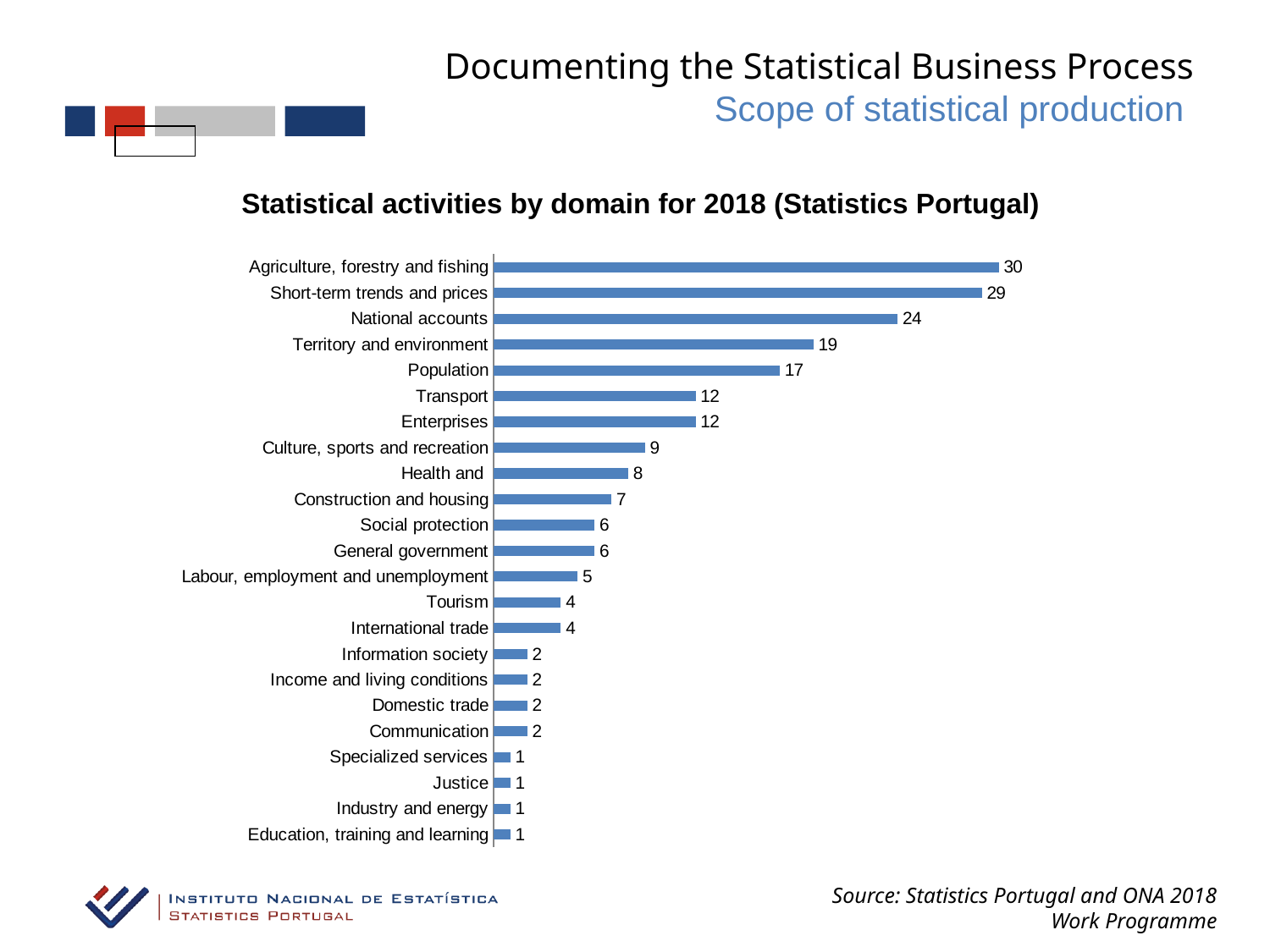
What is the difference between Territory and environment and Transport? 7 What is the value for National accounts? 24 What is the lowest value shown on the chart? 1 What is the title of the chart? Statistical activities by domain for 2018 (Statistics Portugal) What is the difference between Agriculture, forestry and fishing and Short-term trends and prices? 1 Which domain has the highest value? Agriculture, forestry and fishing What is the value for Culture, sports and recreation? 9 How many domains are shown on the chart? 23 What is the value for Population? 17 What is the value for Labour, employment and unemployment? 5 Which is larger, Construction and housing or Social protection? Construction and housing What kind of chart is this? Bar chart